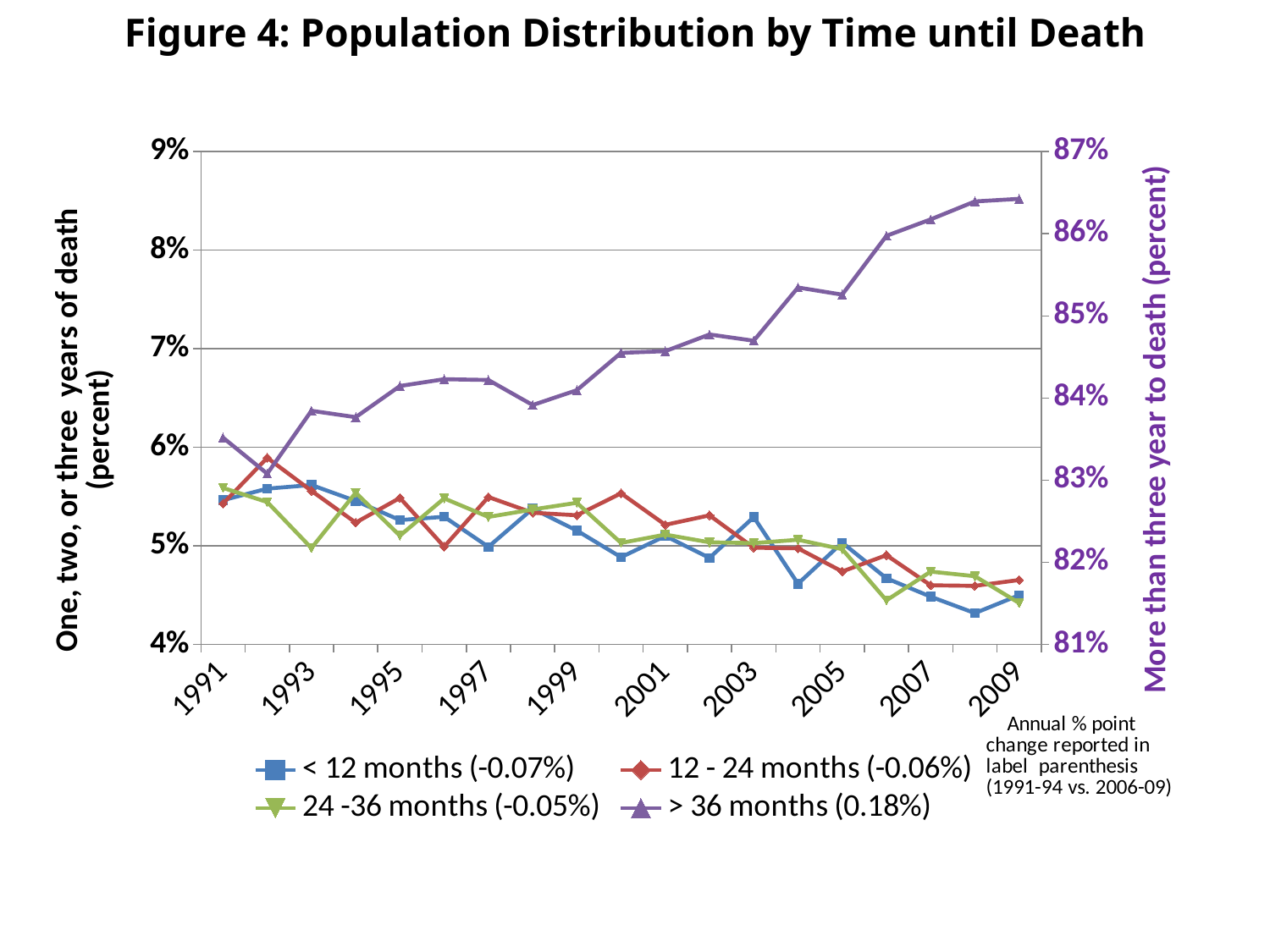
What annual percentage point change is reported in the legend label for > 36 months? 0.18% Is the value for 12 - 24 months in 1992 greater or less than 5.5%? greater How many yearly data points does each series have? 19 Is the value for < 12 months in 2009 greater or less than 5%? less What kind of chart is shown on the slide? line chart Does the < 12 months series rise or fall overall from 1991 to 2009? fall In 2004, which is larger: the value for < 12 months or the value for 12 - 24 months? 12 - 24 months Is the value for > 36 months in 1991 greater or less than 84%? less Does the > 36 months series rise or fall from 1991 to 2009? rise How many series does the legend list? 4 What is the title of the chart? Figure 4: Population Distribution by Time until Death